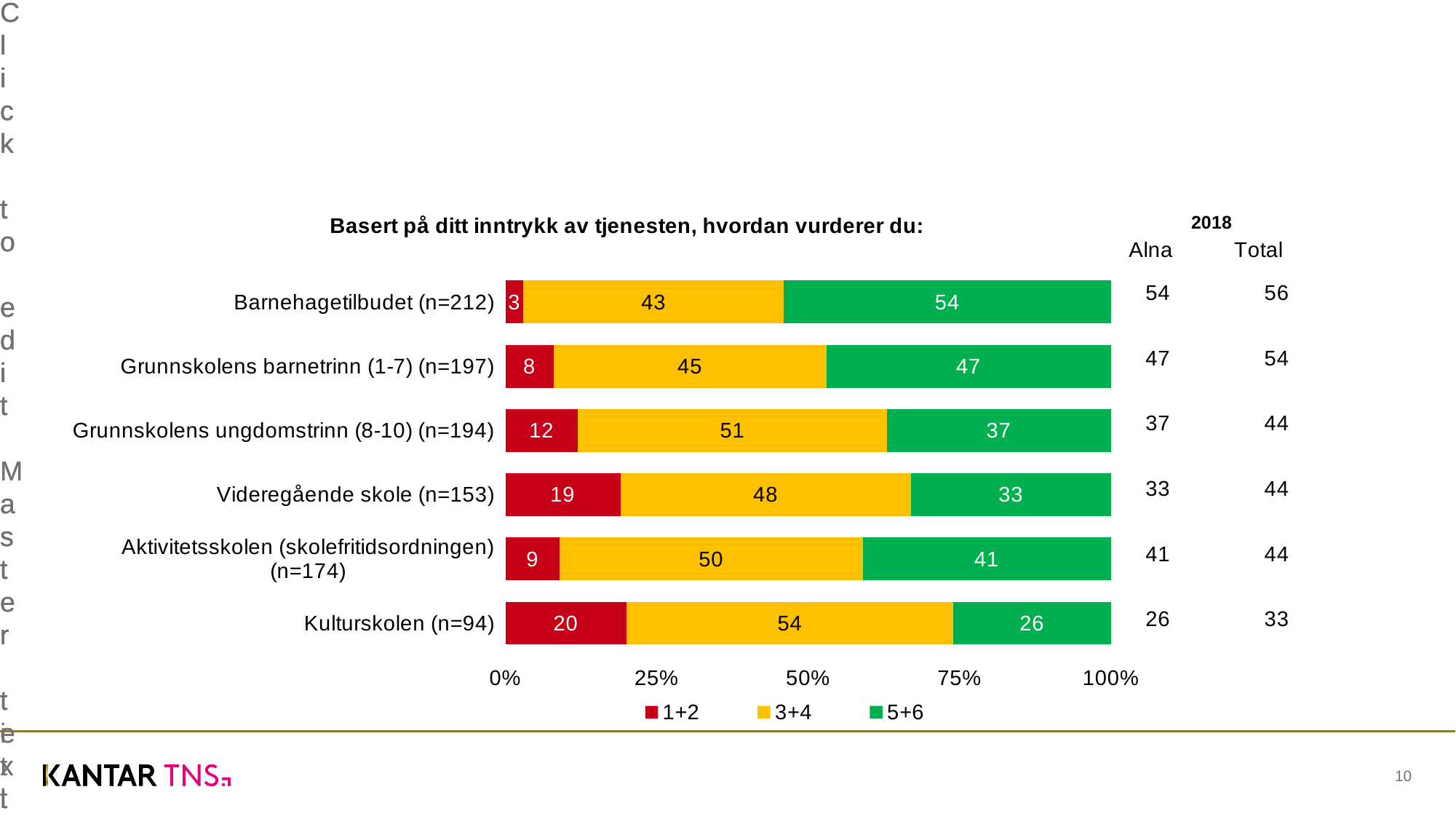
Which category has the highest 5+6 value? Barnehagetilbudet (n=212) What is the difference between the 5+6 values for Grunnskolens barnetrinn (1-7) (n=197) and Videregående skole (n=153)? 14 What is the title of the chart? Basert på ditt inntrykk av tjenesten, hvordan vurderer du: Which is larger: the 1+2 value for Videregående skole (n=153) or for Aktivitetsskolen (skolefritidsordningen) (n=174)? Videregående skole (n=153) How many categories are shown in the chart? 6 Which category has the lowest 1+2 value? Barnehagetilbudet (n=212) What is the total of the stacked bar for Kulturskolen (n=94)? 100 What is the value of the 3+4 segment for Grunnskolens ungdomstrinn (8-10) (n=194)? 51 What kind of chart is shown on the slide? Stacked bar chart What is the value of the 1+2 segment for Kulturskolen (n=94)? 20 What is the value of the 5+6 segment for Barnehagetilbudet (n=212)? 54 How many series does the legend list? 3